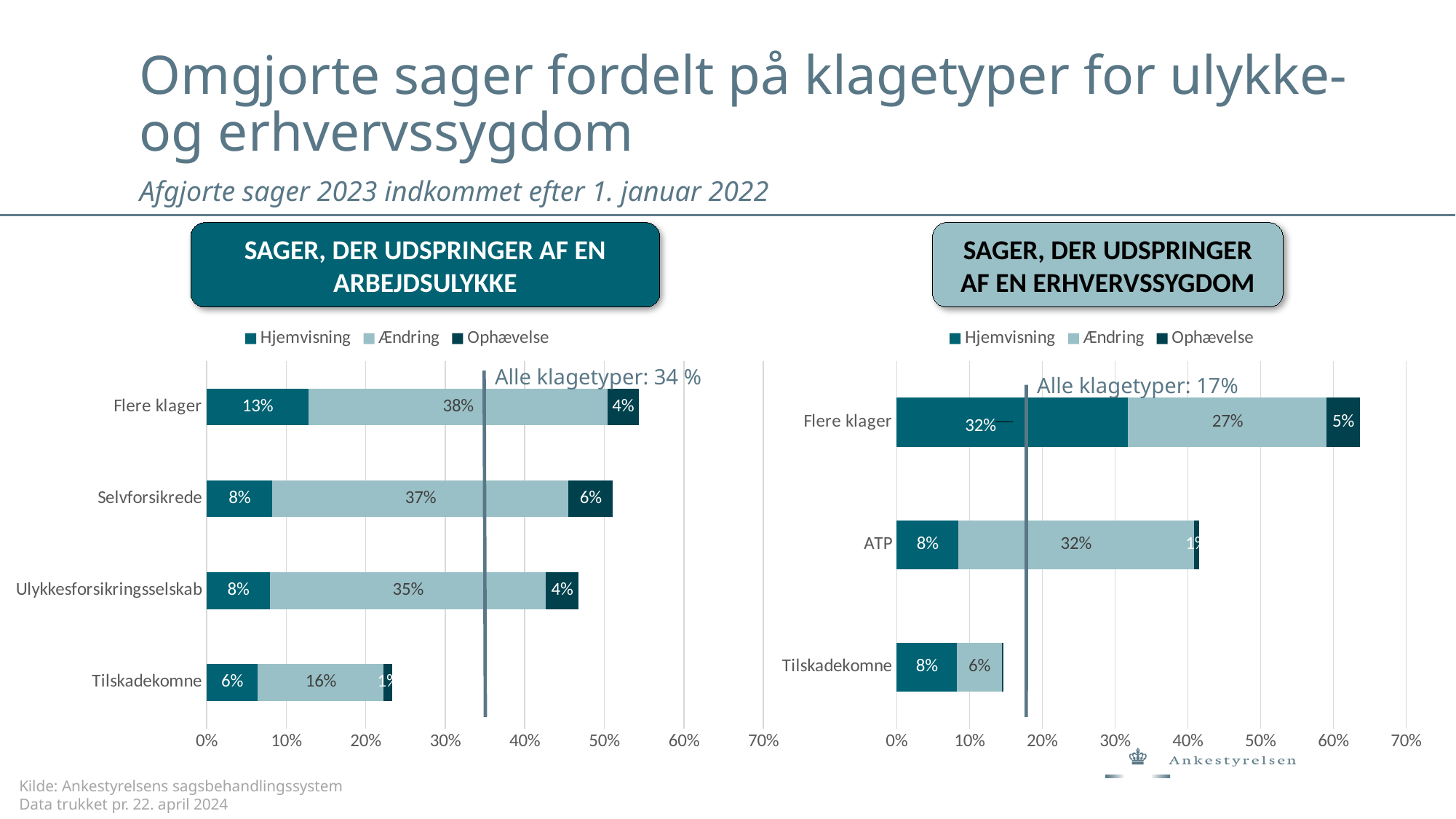
In the chart 'Sager, der udspringer af en erhvervssygdom', is the Ændring value for Flere klager larger or smaller than the Ændring value for ATP? smaller In the chart 'Sager, der udspringer af en arbejdsulykke', what is the total of the stacked bar for Flere klager? 55% In the chart 'Sager, der udspringer af en erhvervssygdom', what is the total of the stacked bar for ATP? 41% In the chart 'Sager, der udspringer af en erhvervssygdom', what is the Hjemvisning value for Flere klager? 32% How many categories are shown in the chart 'Sager, der udspringer af en erhvervssygdom'? 3 In the chart 'Sager, der udspringer af en arbejdsulykke', what is the Ophævelse value for Selvforsikrede? 6% In the chart 'Sager, der udspringer af en arbejdsulykke', which category has the highest Hjemvisning value? Flere klager In the chart 'Sager, der udspringer af en arbejdsulykke', what is the difference between the Ændring values for Selvforsikrede and Tilskadekomne? 21 percentage points In the chart 'Sager, der udspringer af en arbejdsulykke', which category has the lowest Ændring value? Tilskadekomne How many series does the legend list in the chart 'Sager, der udspringer af en arbejdsulykke'? 3 In the chart 'Sager, der udspringer af en erhvervssygdom', what is the Ændring value for ATP? 32% In the chart 'Sager, der udspringer af en arbejdsulykke', what is the Ændring value for Flere klager? 38%